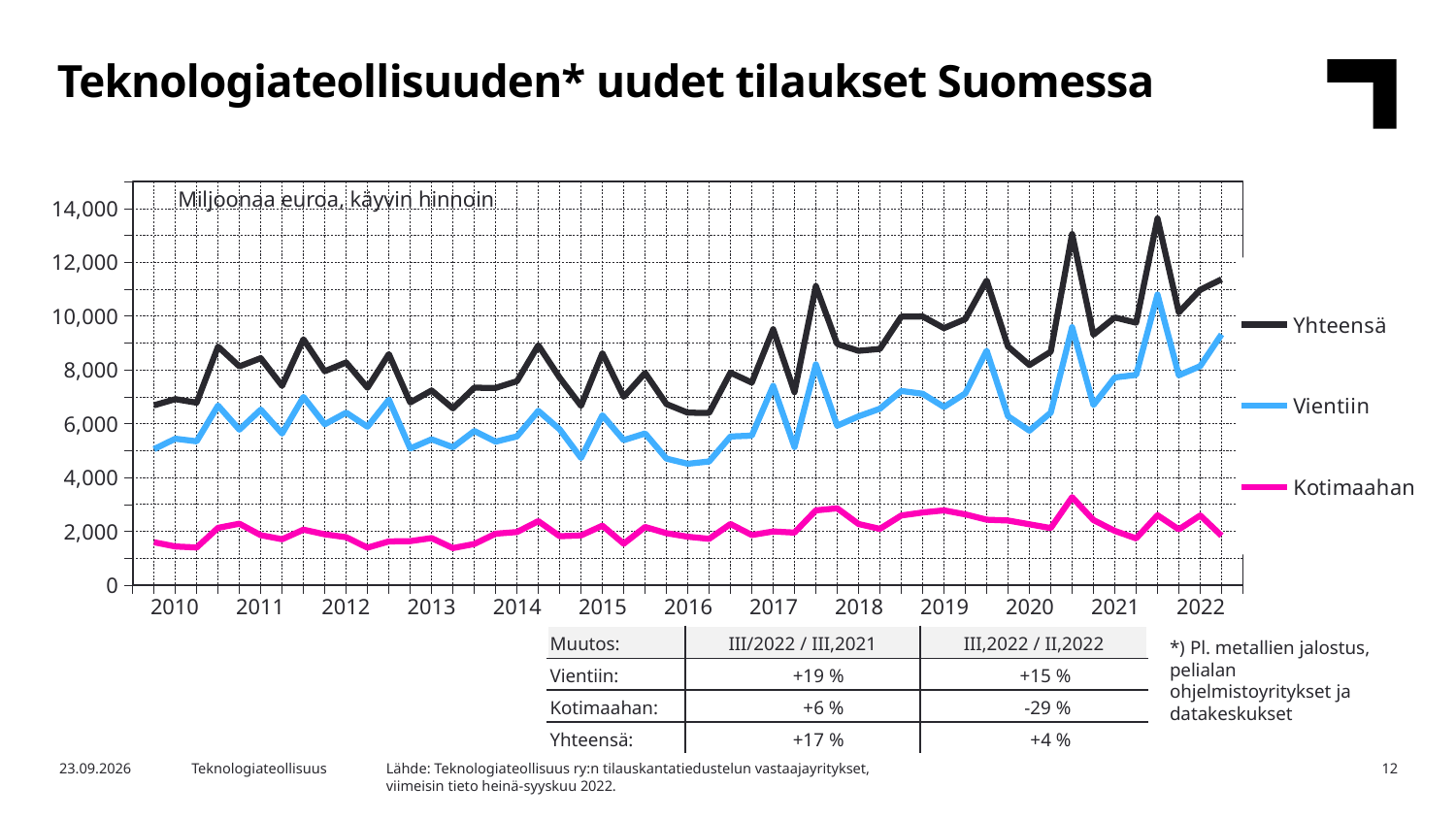
Is the peak value for Yhteensä in 2021 greater or less than 12,000? greater What kind of chart is shown on the slide? line chart How many series does the legend list? 3 How many years are labelled on the x axis? 13 Does the Yhteensä line overall rise or fall from 2010 to 2022? rise Is the value for Vientiin at the start of 2016 greater or less than 6,000? less Is the value for Kotimaahan at the start of 2010 greater or less than 4,000? less What unit is stated in the label at the top of the chart? Miljoonaa euroa, käyvin hinnoin Which series is shown in black in the legend? Yhteensä Which series has the lowest values throughout the chart? Kotimaahan Which series has the highest values throughout the chart? Yhteensä Which is larger at the end of 2022, Vientiin or Kotimaahan? Vientiin